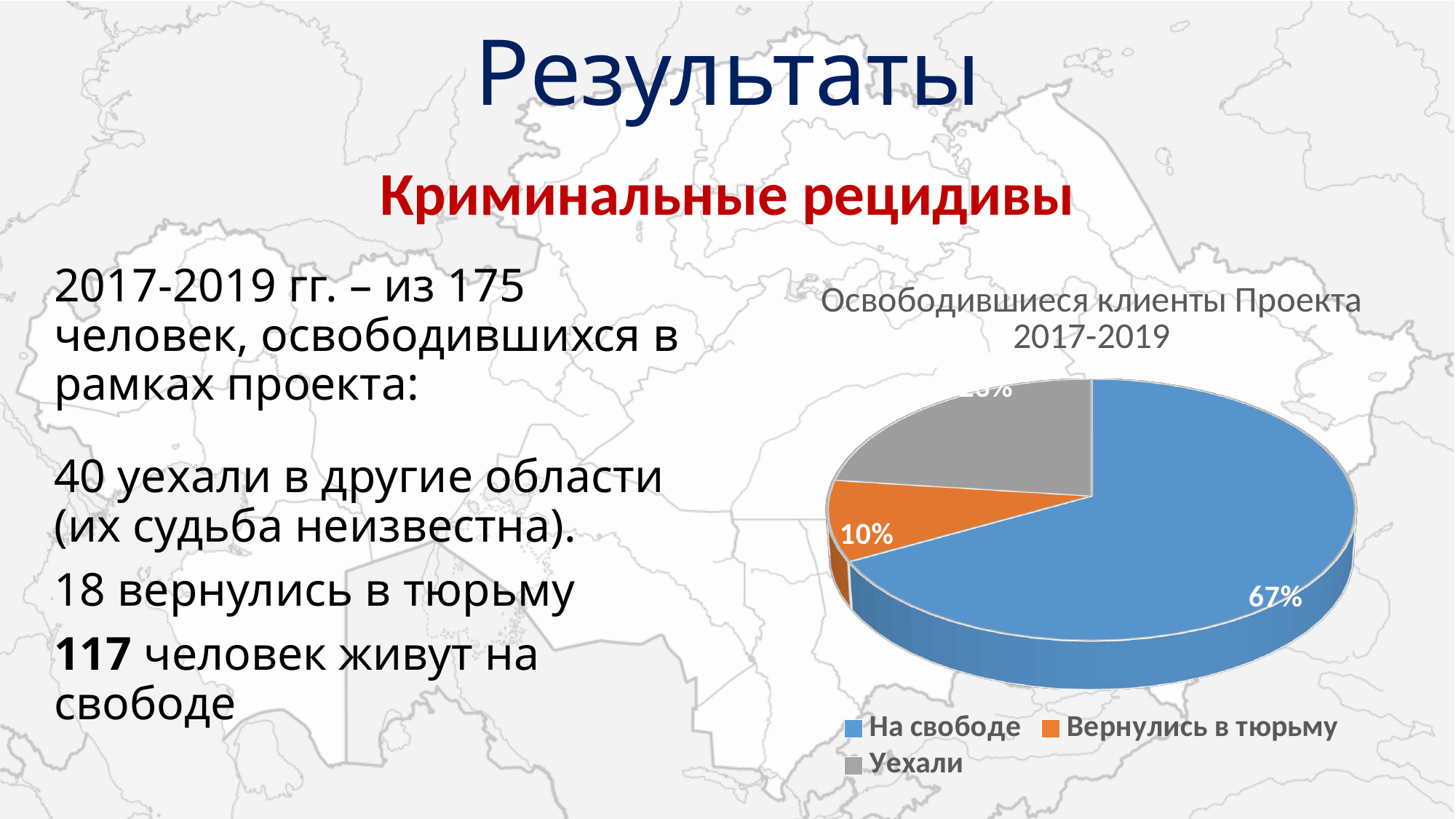
Which category has the smallest slice of the pie chart? Вернулись в тюрьму Which slice is larger: "На свободе" or "Уехали"? На свободе What is the difference in percentage points between the "На свободе" slice and the "Вернулись в тюрьму" slice? 57 percentage points Which slice is larger: "Уехали" or "Вернулись в тюрьму"? Уехали What percentage of the pie chart is labelled for "Вернулись в тюрьму"? 10% What colour is the "На свободе" slice in the pie chart? Blue What kind of chart is shown on the slide? Pie chart How many slices does the pie chart have? 3 Which category has the largest slice of the pie chart? На свободе How many entries does the chart legend list? 3 What is the title of the chart? Освободившиеся клиенты Проекта 2017-2019 What percentage of the pie chart is labelled for "На свободе"? 67%